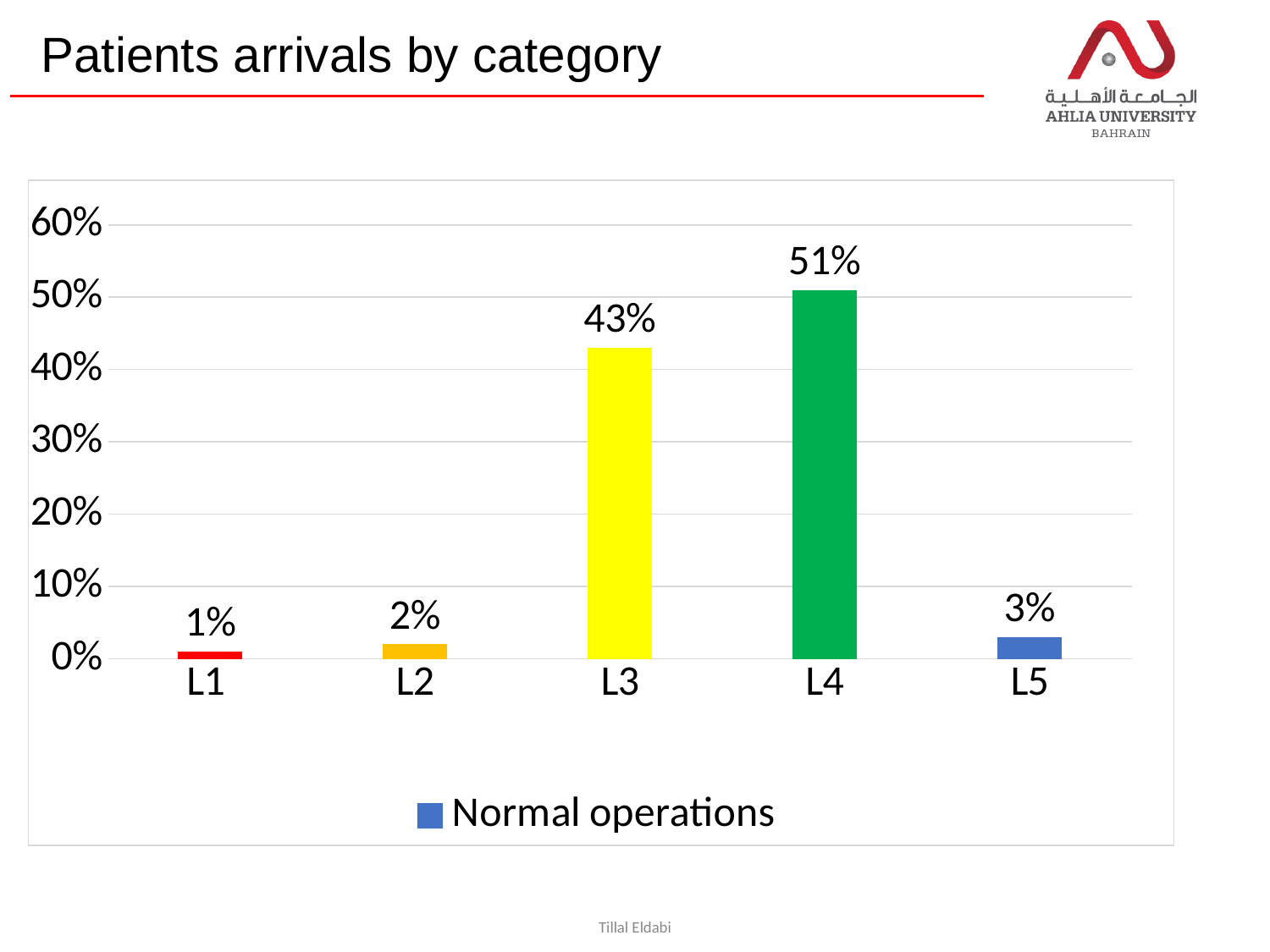
Which is larger, the value for L2 or the value for L5? L5 What is the difference between the values for L4 and L3? 8% How many categories are shown on the x axis? 5 What is the value for L5? 3% What is the value for L3? 43% What is the value for L1? 1% Is the value for L3 greater or less than 40%? greater What is the value for L4? 51% Which category has the highest value? L4 What kind of chart is shown on the slide? bar chart What series name does the legend show? Normal operations Which category has the lowest value? L1